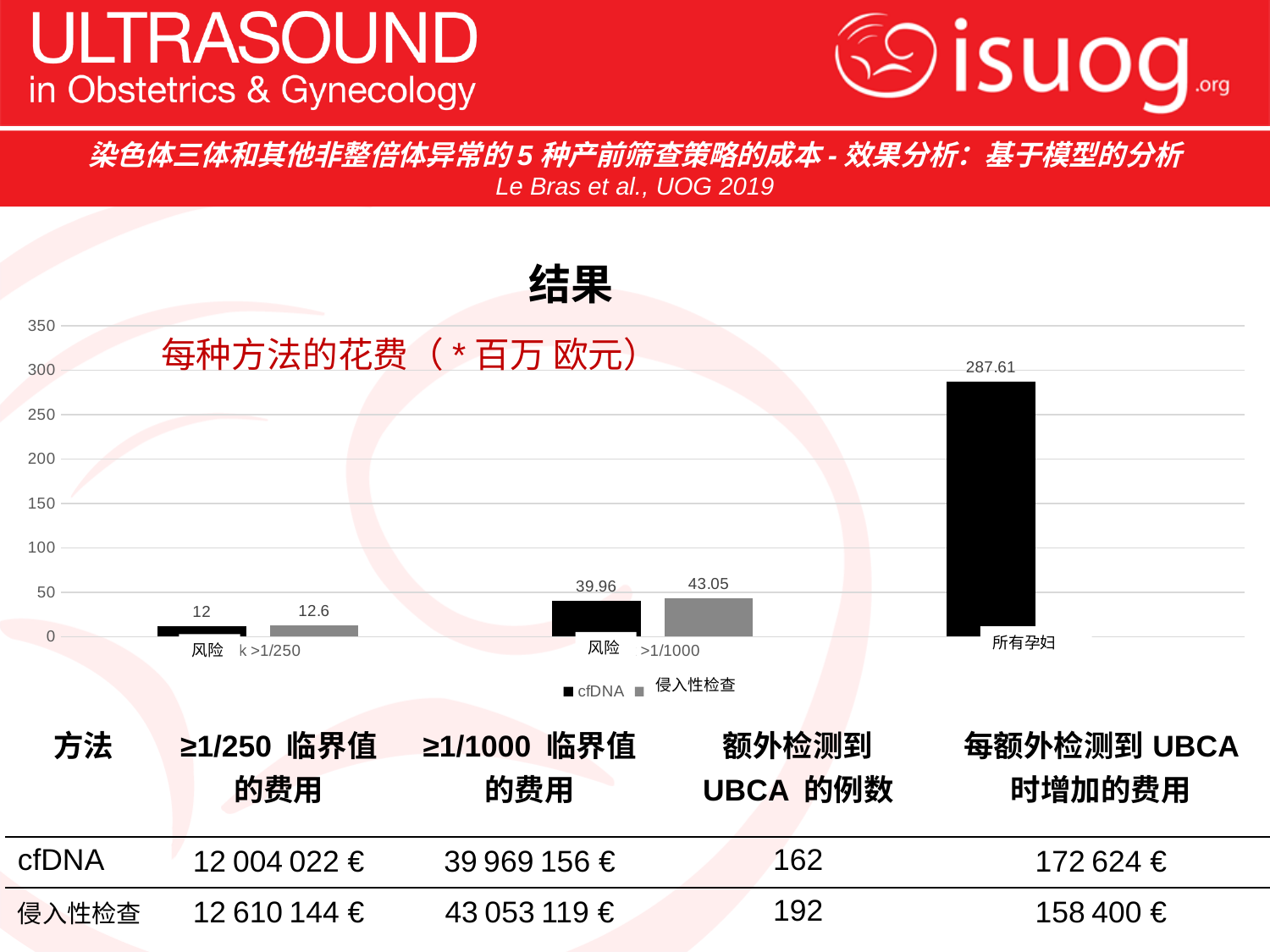
For the 风险 >1/1000 category, which is larger: cfDNA or 侵入性检查? 侵入性检查 Which category has the highest cfDNA value? 所有孕妇 What is the cfDNA value for the 风险 >1/1000 category? 39.96 What kind of chart is shown on the slide? bar chart What is the difference between the 侵入性检查 and cfDNA values for the 风险 >1/1000 category? 3.09 How many series does the chart legend list? 2 Is the cfDNA value for 所有孕妇 greater or less than 250? greater What is the 侵入性检查 value for the 风险 >1/1000 category? 43.05 What is the cfDNA value for the 所有孕妇 category? 287.61 What is the 侵入性检查 value for the 风险 k >1/250 category? 12.6 Which category has the lowest cfDNA value? 风险 k >1/250 What is the title of the chart? 结果